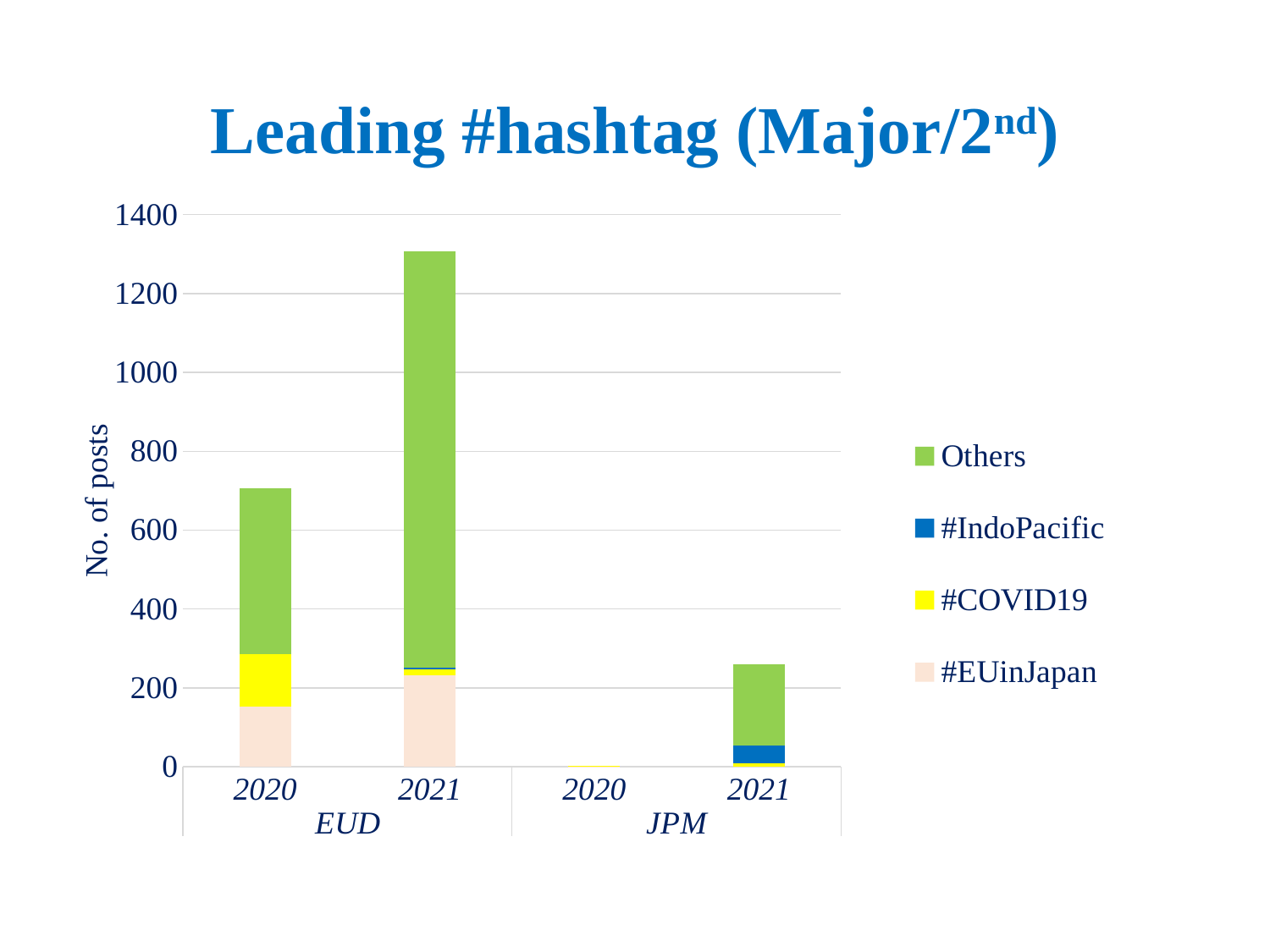
Is the total for JPM 2021 greater or less than 400? less Is the total for EUD 2020 greater or less than 600? greater What kind of chart is shown on the slide? bar chart How many series does the legend list? 4 Which has a larger total, EUD 2020 or JPM 2021? EUD 2020 How many bars (year-group combinations) are plotted on the x axis? 4 Which bar has the lowest total number of posts? JPM 2020 Which bar has the highest total number of posts? EUD 2021 What is the title of the chart? Leading #hashtag (Major/2nd) What is the label on the vertical axis? No. of posts For EUD, does the total number of posts rise or fall from 2020 to 2021? rise Is the total for EUD 2021 greater or less than 1200? greater